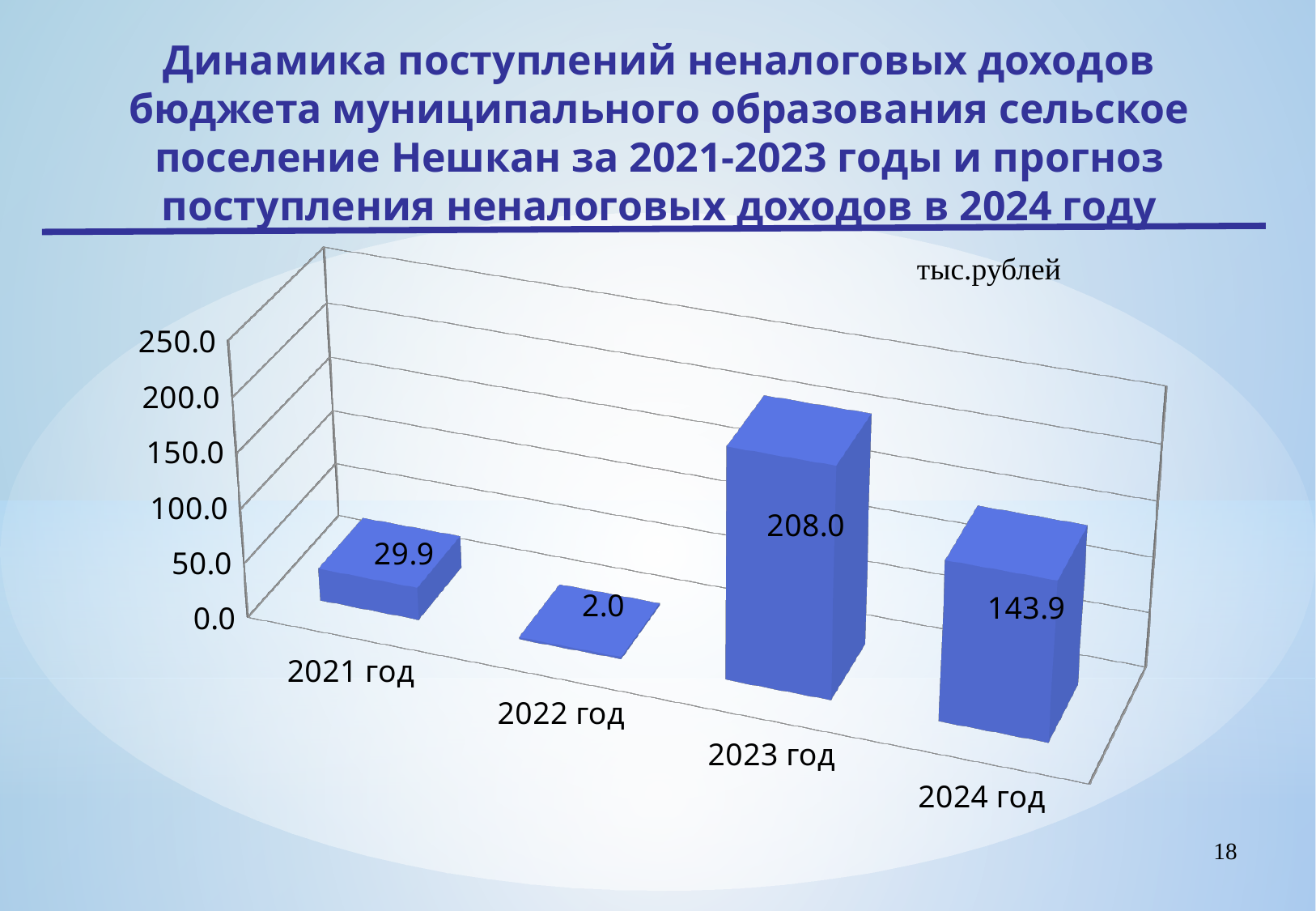
What is the difference between the values for 2023 год and 2024 год? 64.1 What is the value for 2023 год? 208.0 What is the forecast value for 2024 год? 143.9 Which year has the highest value? 2023 год What unit of measurement is indicated on the chart? тыс.рублей What is the value for 2022 год? 2.0 How many years are shown on the chart? 4 Which is larger, the value for 2021 год or the value for 2024 год? 2024 год What is the difference between the values for 2021 год and 2022 год? 27.9 What kind of chart is shown on the slide? bar chart What is the value for 2021 год? 29.9 Which year has the lowest value? 2022 год